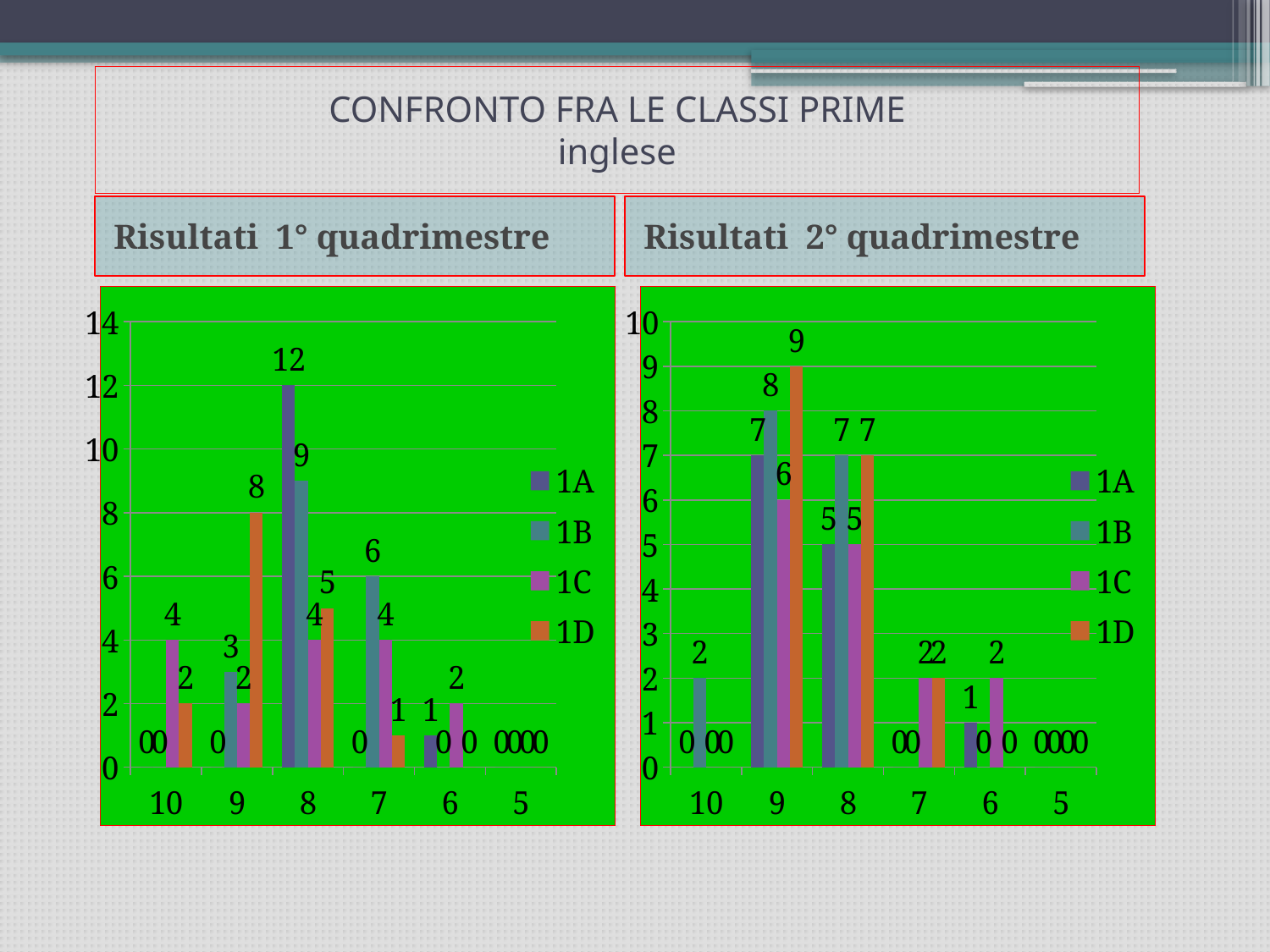
In the 'Risultati 1° quadrimestre' chart, what is the value for 1A at grade 8? 12 How many grade categories are shown on the x axis of the 'Risultati 1° quadrimestre' chart? 6 In the 'Risultati 1° quadrimestre' chart, what is the value for 1D at grade 9? 8 In the 'Risultati 1° quadrimestre' chart, what is the difference between the 1A and 1B values at grade 8? 3 In the 'Risultati 2° quadrimestre' chart, which series has the lowest value at grade 9? 1C In the 'Risultati 2° quadrimestre' chart, what is the total of the four series' values at grade 9? 30 In the 'Risultati 1° quadrimestre' chart, which series has the highest value at grade 8? 1A In the 'Risultati 2° quadrimestre' chart, what is the value for 1D at grade 9? 9 In the 'Risultati 2° quadrimestre' chart, what is the value for 1B at grade 10? 2 What kind of chart is the 'Risultati 1° quadrimestre' chart? Bar chart In the 'Risultati 2° quadrimestre' chart, which is larger at grade 8: the value for 1B or the value for 1A? 1B How many series does the legend of the 'Risultati 2° quadrimestre' chart list? 4